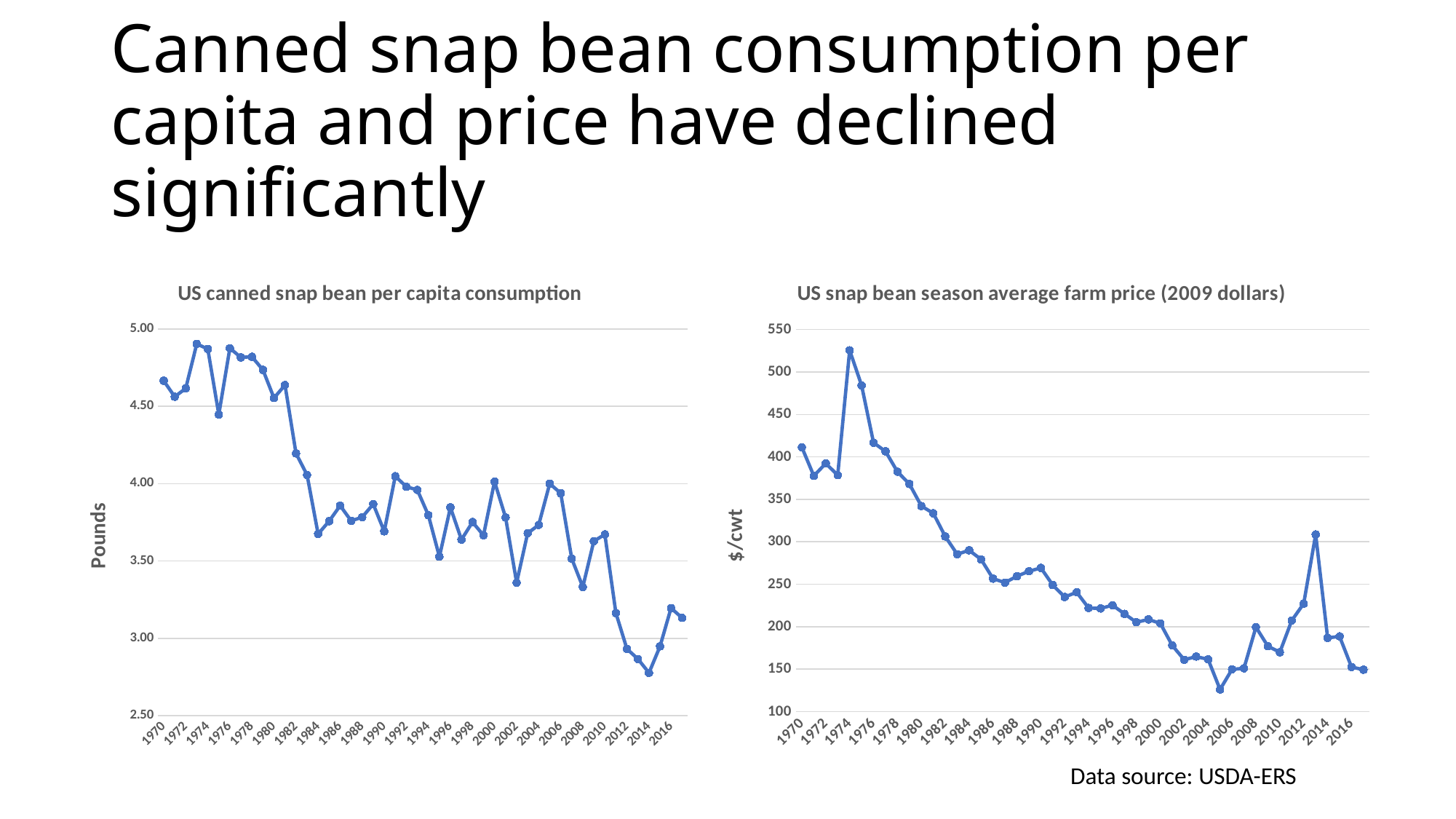
In the 'US snap bean season average farm price (2009 dollars)' chart, which year has the lowest value? 2005 What is the y-axis label of the 'US canned snap bean per capita consumption' chart? Pounds What is the y-axis label of the 'US snap bean season average farm price (2009 dollars)' chart? $/cwt In the 'US canned snap bean per capita consumption' chart, do values generally rise or fall from 1970 to 2016? fall What kind of chart is the 'US canned snap bean per capita consumption' chart? line chart In the 'US snap bean season average farm price (2009 dollars)' chart, is the value for 1974 larger or smaller than the value for 2013? larger In the 'US canned snap bean per capita consumption' chart, which year has the lowest value? 2014 In the 'US canned snap bean per capita consumption' chart, is the value for 1970 greater or less than 4.50? greater In the 'US snap bean season average farm price (2009 dollars)' chart, is the value for 1974 greater or less than 500? greater In the 'US snap bean season average farm price (2009 dollars)' chart, which year has the highest value? 1974 In the 'US canned snap bean per capita consumption' chart, is the value for 2014 greater or less than 3.00? less